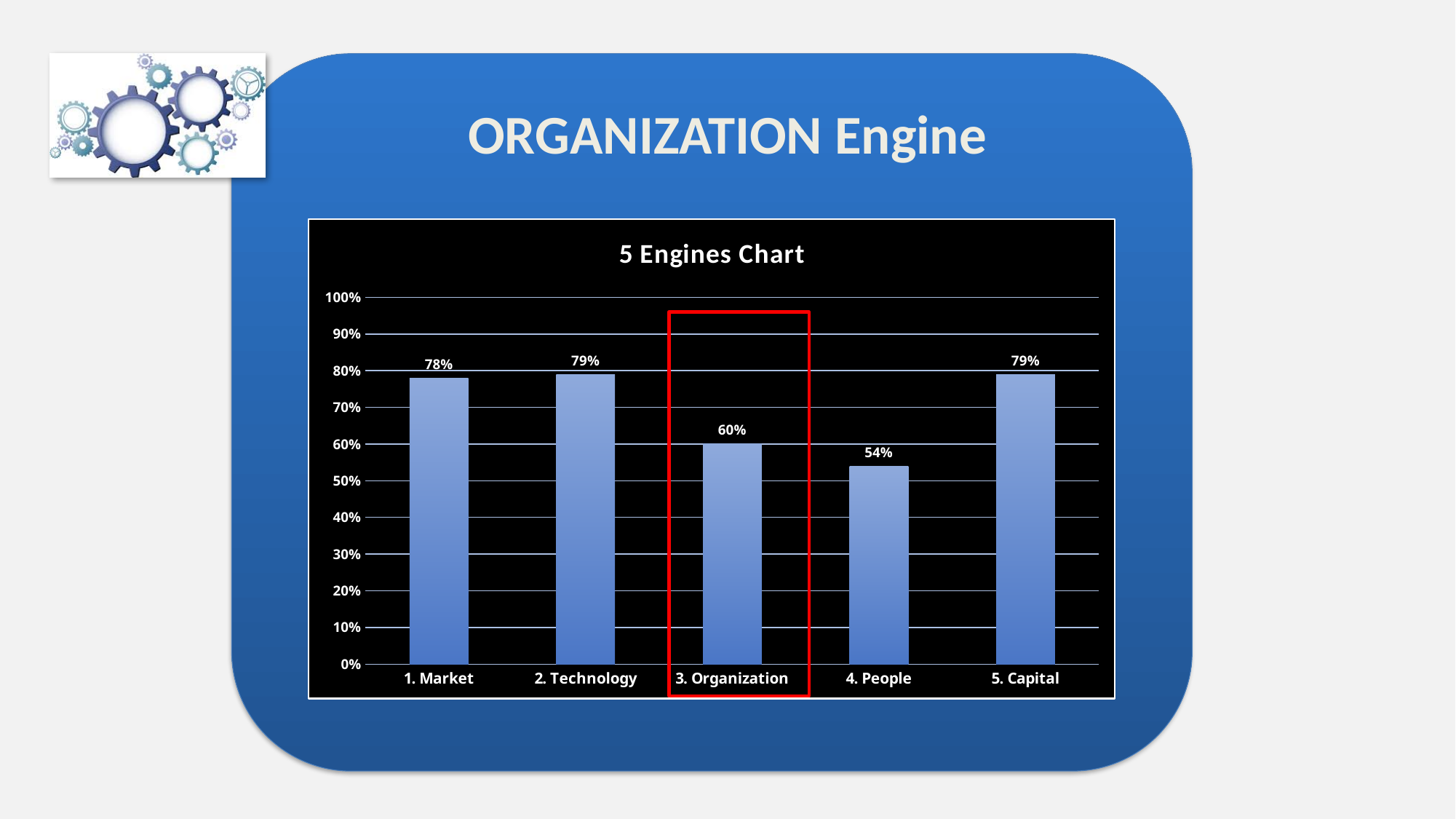
What is the difference between the values for 2. Technology and 3. Organization? 19% What is the value for 4. People? 54% Which category is highlighted with a red box? 3. Organization What is the value for 1. Market? 78% What is the difference between the values for 1. Market and 4. People? 24% What kind of chart is shown on the slide? bar chart Is the value for 5. Capital greater or less than 70%? greater How many categories are shown in the chart? 5 Which is larger, the value for 3. Organization or the value for 4. People? 3. Organization Which category has the lowest value? 4. People What is the value for 3. Organization in the 5 Engines Chart? 60% What is the title of the chart? 5 Engines Chart